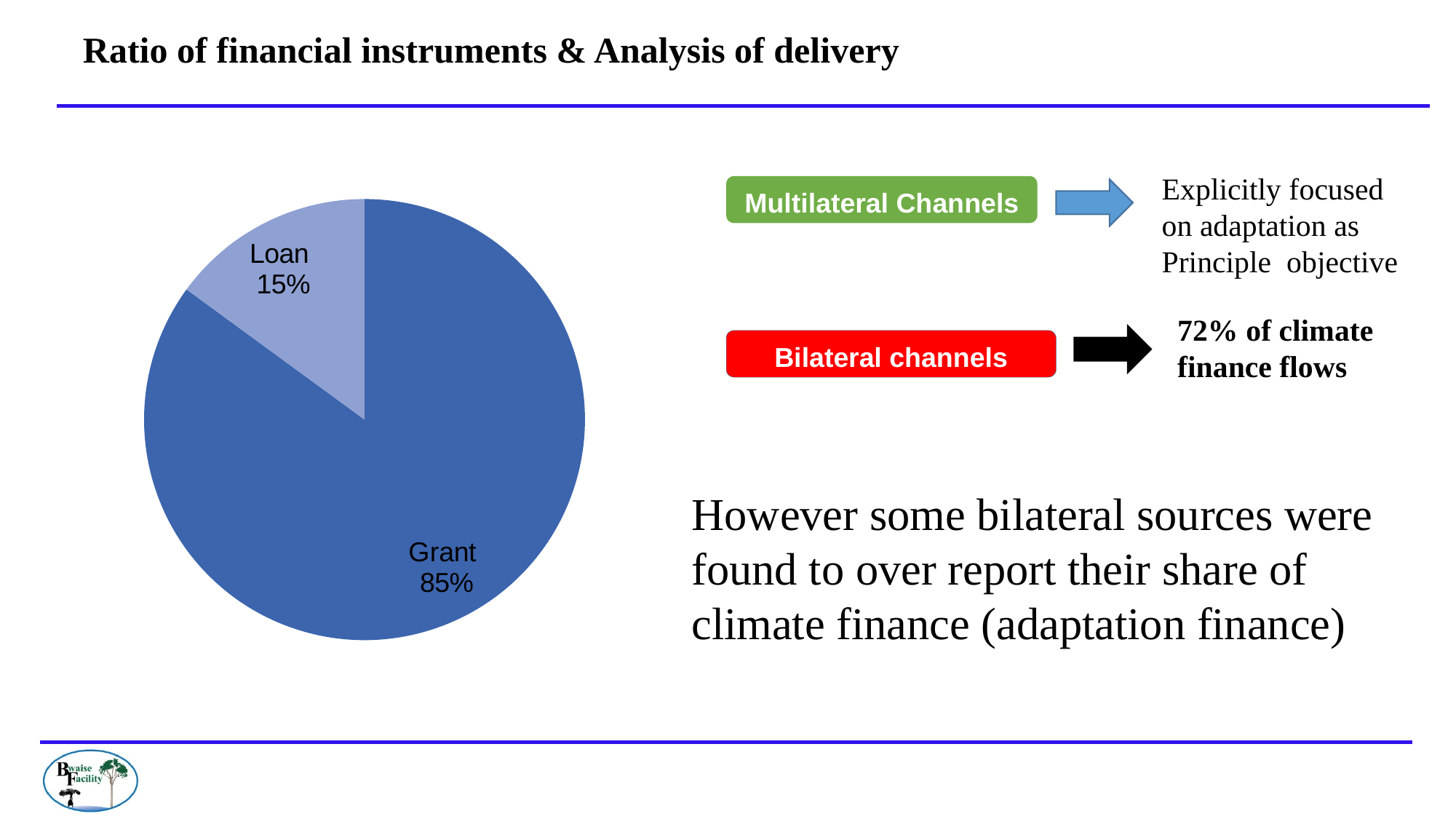
What kind of chart is shown on the slide? pie chart What share of the pie does Grant represent? 85% Which slice of the pie chart is shown in the lighter blue colour? Loan Which slice of the pie chart is the smallest? Loan What is the title of the slide containing the pie chart? Ratio of financial instruments & Analysis of delivery Which is larger, the Grant slice or the Loan slice? Grant Which slice of the pie chart is the largest? Grant What is the combined share of the Grant and Loan slices? 100% What share of the pie does Loan represent? 15% What is the difference in percentage points between the Grant and Loan slices? 70 How many slices does the pie chart have? 2